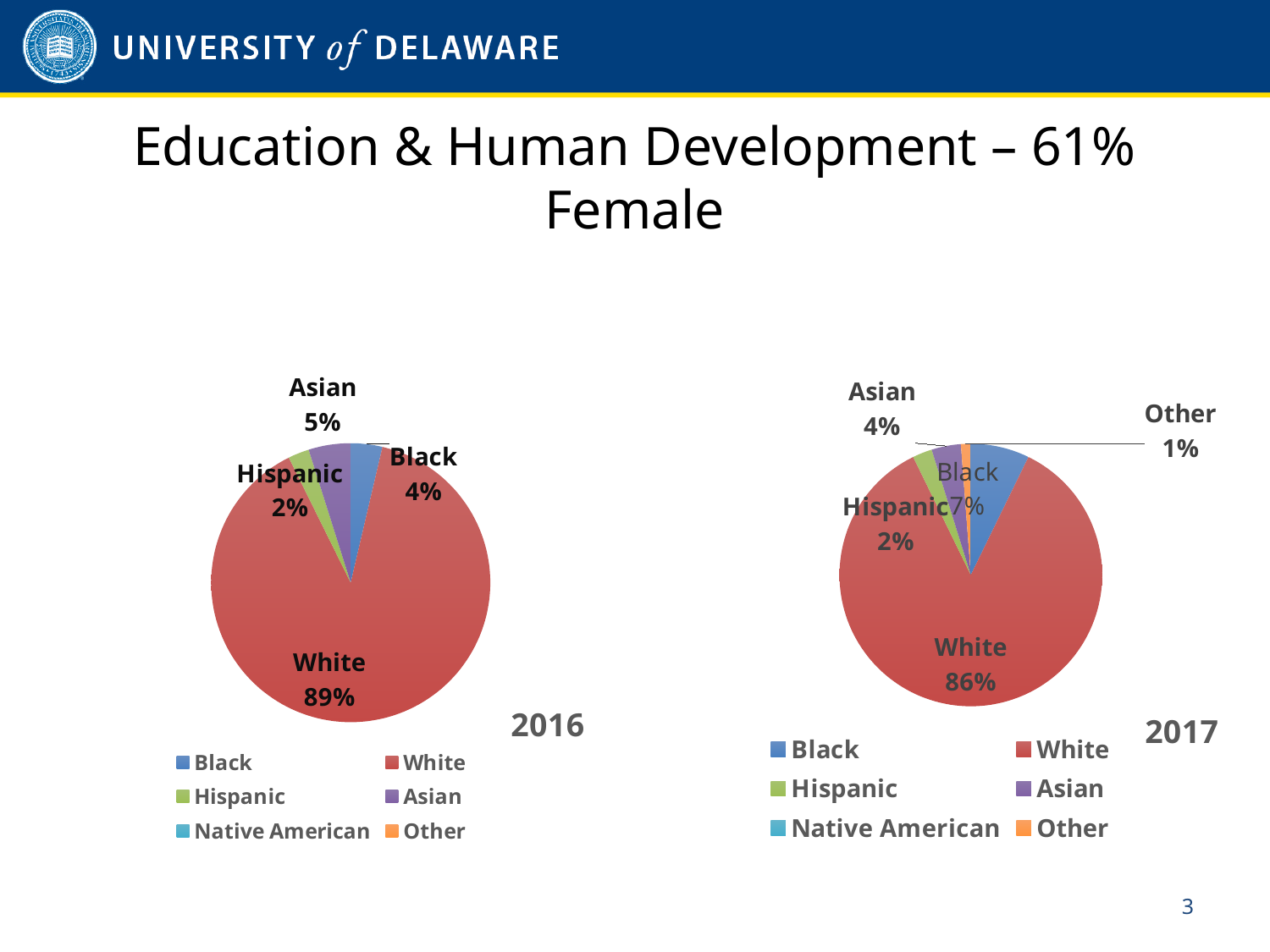
In the 2017 pie chart, what share is Other? 1% What kind of chart is used for the 2016 data? Pie chart What is the difference between the Black share in 2017 and the Black share in 2016? 3% In the 2016 pie chart, what share is White? 89% How many entries does the legend of the 2016 pie chart list? 6 In the 2017 pie chart, which labelled category has the smallest share? Other In the 2016 pie chart, which category has the largest share? White Which is larger: the Asian share in the 2016 pie chart or the Asian share in the 2017 pie chart? 2016 What colour represents White in the 2017 pie chart? Red In the 2016 pie chart, what share is Asian? 5% In the 2017 pie chart, what share is White? 86% In the 2017 pie chart, what share is Black? 7%